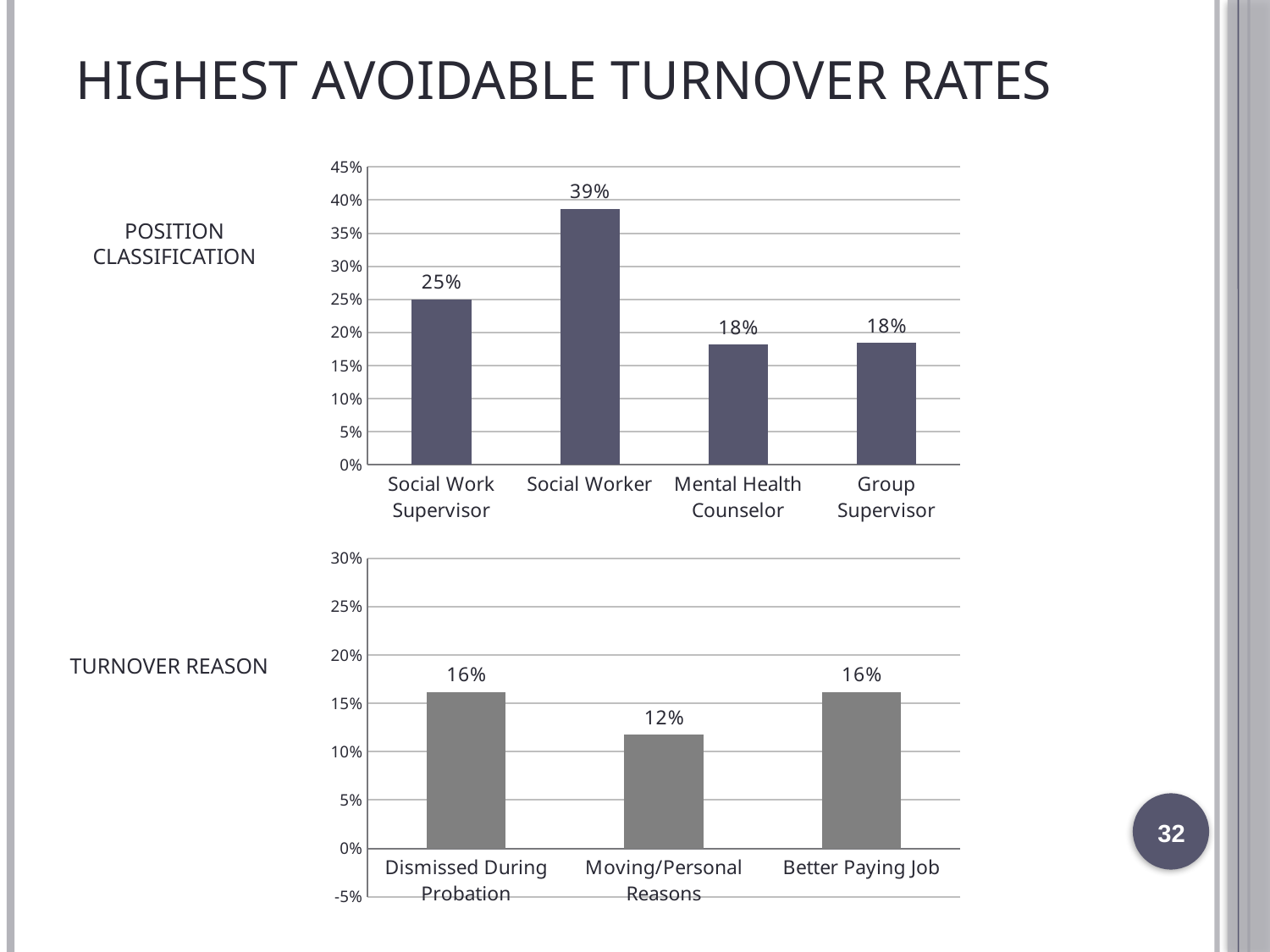
In the Turnover Reason chart, what is the value for Moving/Personal Reasons? 12% In the Position Classification chart, which position has the highest turnover rate? Social Worker In the Position Classification chart, what is the value for Social Worker? 39% In the Turnover Reason chart, what is the difference between Better Paying Job and Moving/Personal Reasons? 4% In the Turnover Reason chart, which reason has the lowest value? Moving/Personal Reasons In the Turnover Reason chart, how many reasons are shown? 3 In the Turnover Reason chart, which is larger, Dismissed During Probation or Moving/Personal Reasons? Dismissed During Probation In the Position Classification chart, what is the value for Social Work Supervisor? 25% In the Position Classification chart, what is the difference between Social Worker and Social Work Supervisor? 14% In the Position Classification chart, how many positions are shown? 4 What kind of chart is the Turnover Reason chart? Bar chart In the Position Classification chart, is the value for Social Worker greater or less than 35%? greater